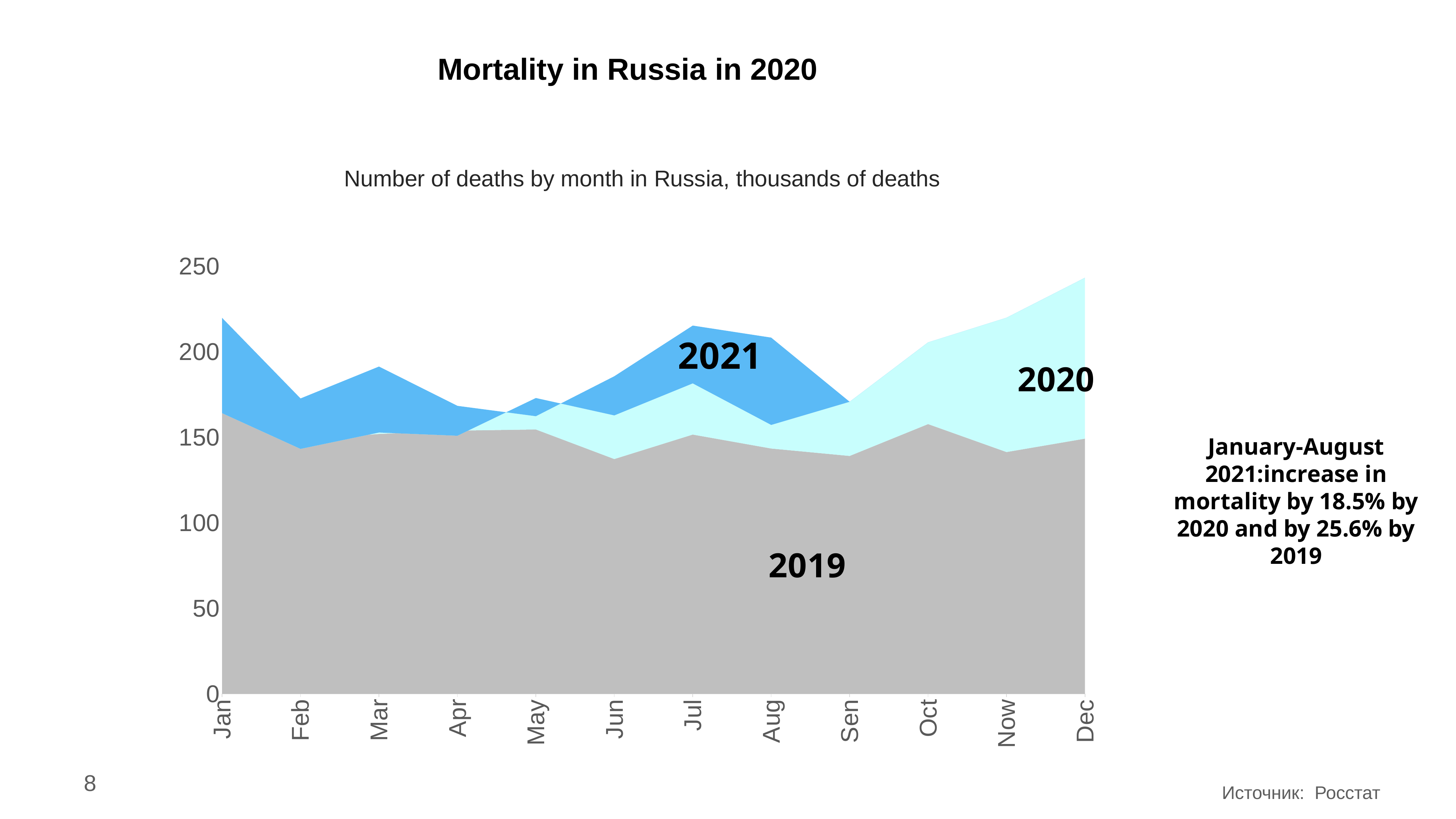
How many data series (years) are plotted in the chart? 3 How many months are shown along the x axis of the chart? 12 In Jul, which series has the larger value, 2021 or 2020? 2021 Does the 2020 series rise or fall from Sen to Dec? Rise What kind of chart is shown on the slide? Area chart Is the value for 2020 in Dec greater or less than 200? greater Is the value for 2019 in Jun greater or less than 150? less Is the value for 2021 in Feb greater or less than 200? less In which month does the 2020 series reach its highest value? Dec In Dec, which series has the larger value, 2020 or 2019? 2020 What is the title of the chart? Mortality in Russia in 2020